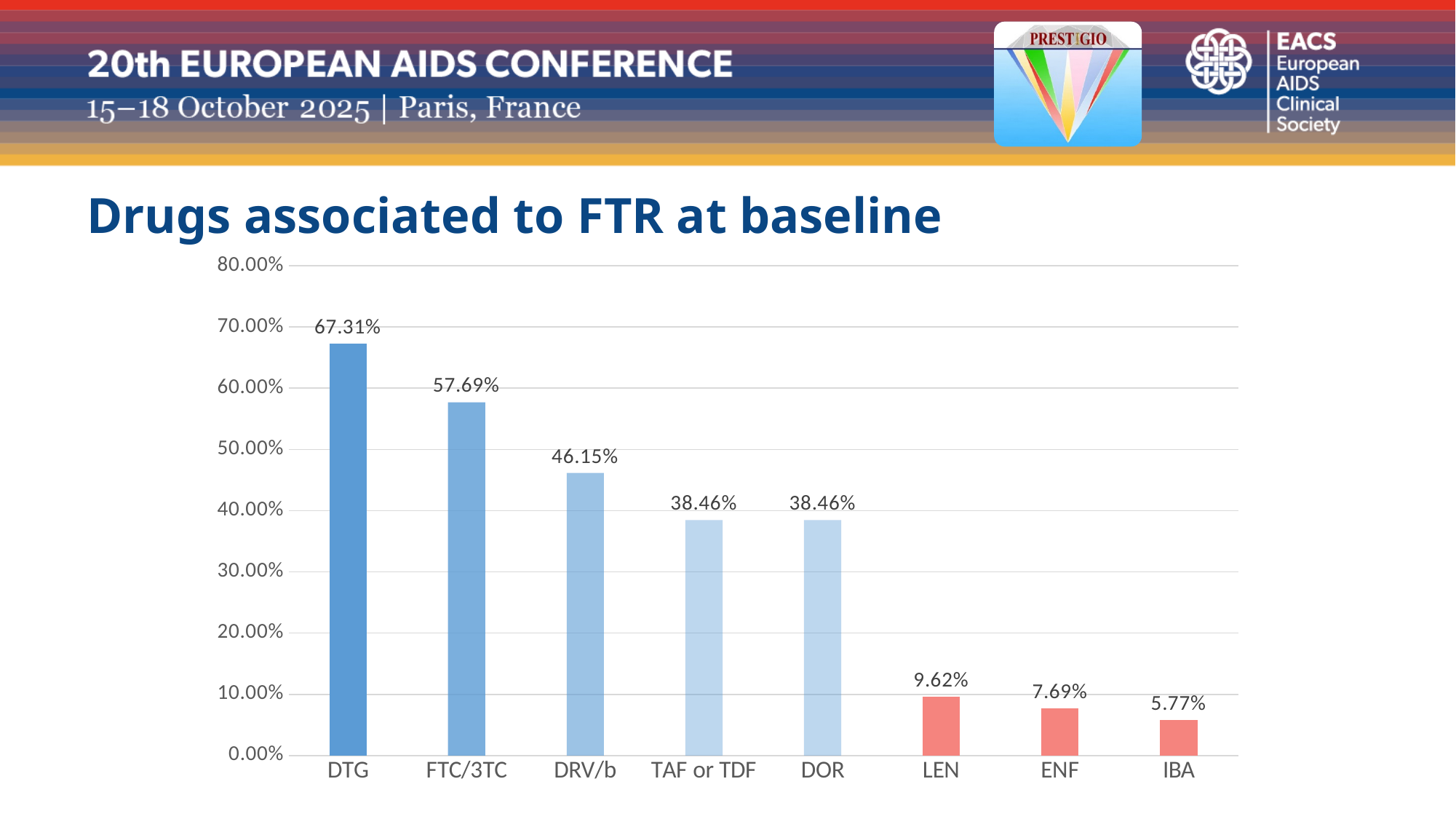
What is the value for DTG? 67.31% What is the difference between the values for DRV/b and DOR? 7.69% What is the value for LEN? 9.62% What is the title of the slide? Drugs associated to FTR at baseline How many drug categories are shown on the x axis? 8 What is the value for IBA? 5.77% What is the difference between the values for DTG and FTC/3TC? 9.62% Which drug has the lowest value? IBA What is the value for FTC/3TC? 57.69% Which is larger, the value for DRV/b or the value for ENF? DRV/b What kind of chart is shown on the slide? Bar chart Which drug has the highest value? DTG